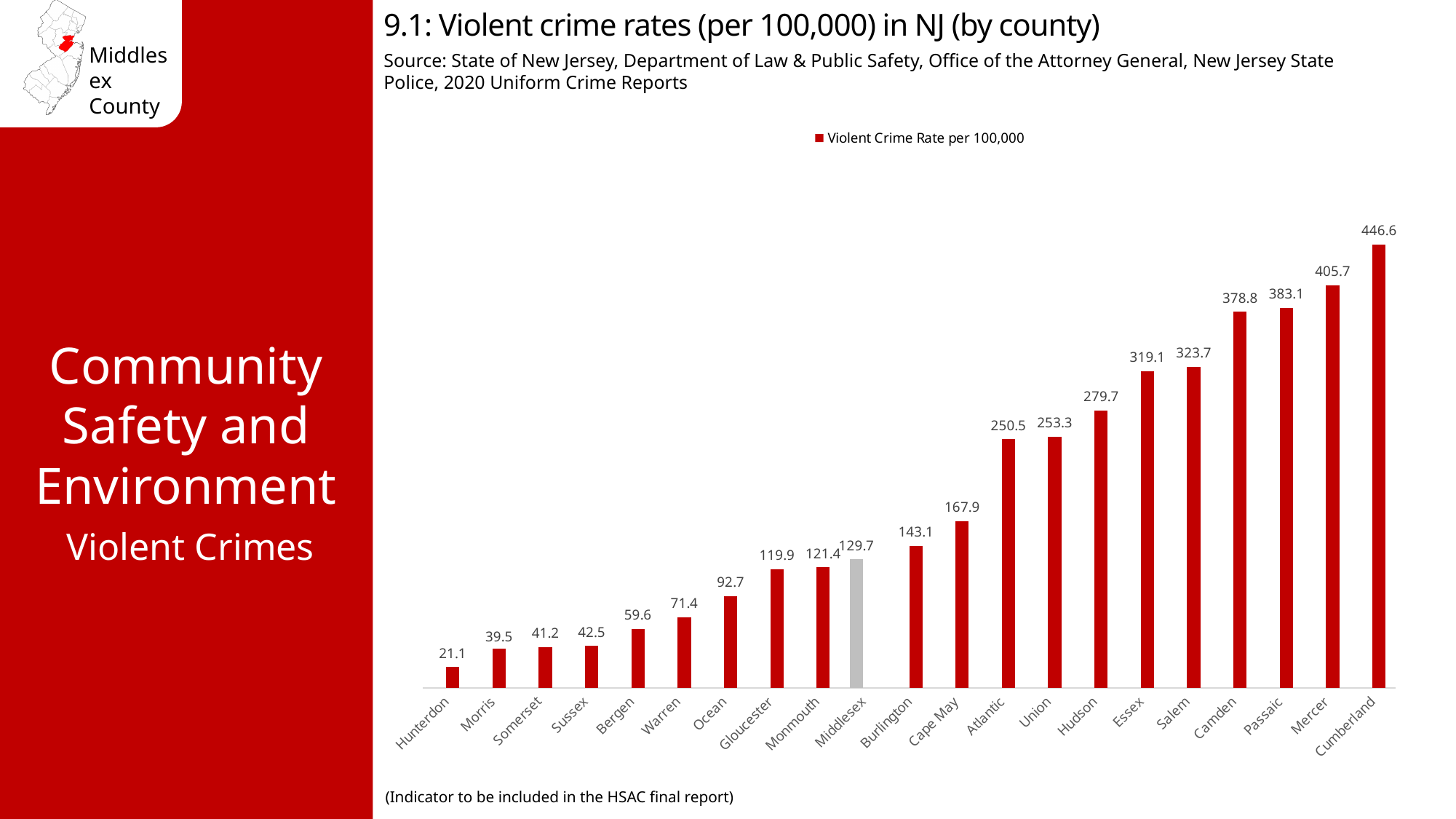
What is the difference between the violent crime rates of Mercer and Camden? 26.9 Which county has the lowest violent crime rate? Hunterdon Which county has the highest violent crime rate? Cumberland What is the difference between the violent crime rates of Cumberland and Hunterdon? 425.5 Which county has a higher violent crime rate, Essex or Cape May? Essex How many series does the legend list? 1 Which county's bar is coloured grey instead of red? Middlesex What is the violent crime rate per 100,000 for Hudson County? 279.7 What kind of chart is shown on the slide? Bar chart Do the values rise or fall from left to right along the x axis? Rise What is the violent crime rate per 100,000 for Middlesex County? 129.7 How many counties are shown on the chart? 21